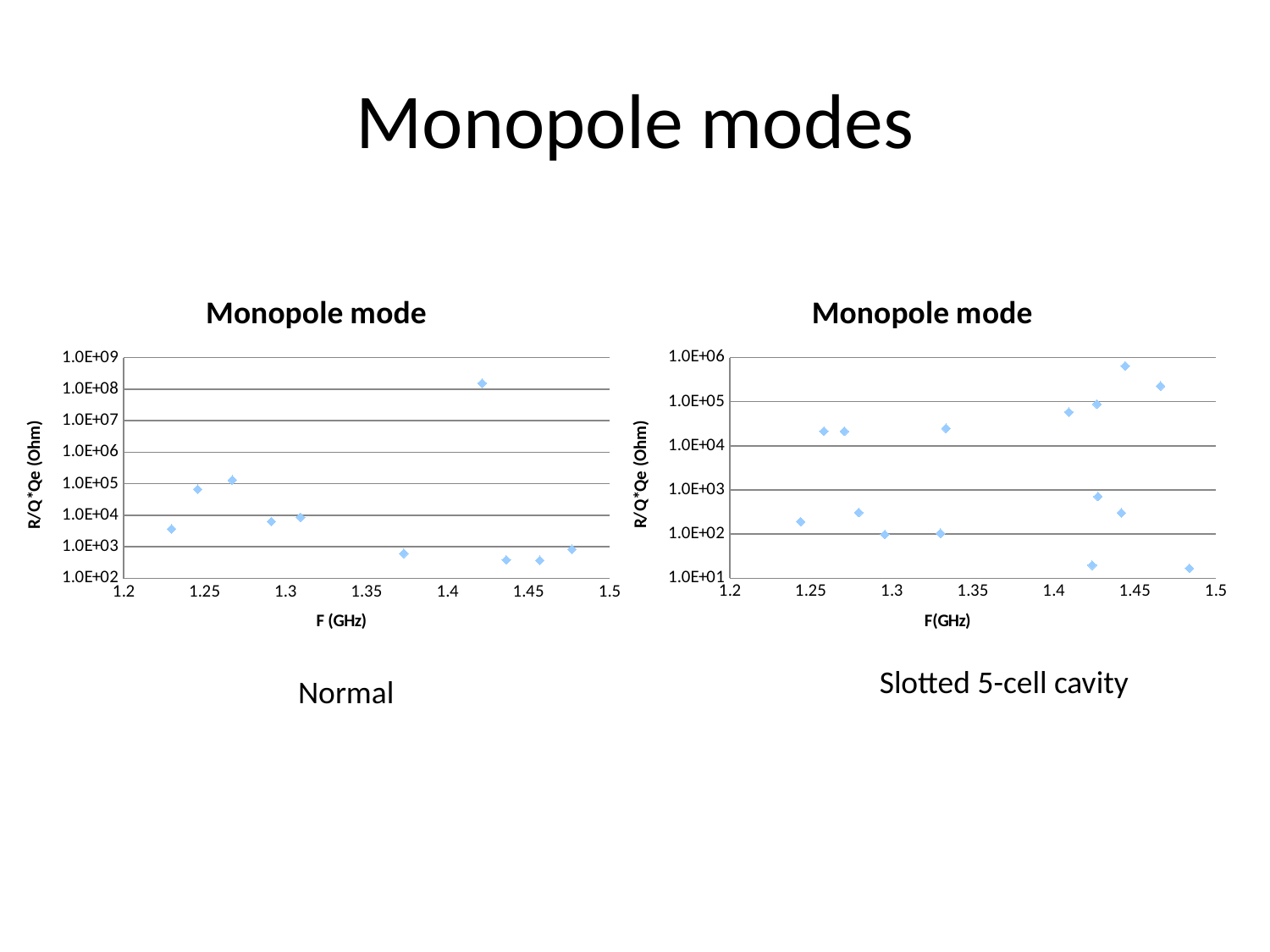
What is the maximum value shown on the y-axis of the left chart labelled "Normal"? 1.0E+09 On the right chart labelled "Slotted 5-cell cavity", is the lowest point greater or less than 1.0E+02? less What is the y-axis label on the left chart labelled "Normal"? R/Q*Qe (Ohm) What is the title of the right chart labelled "Slotted 5-cell cavity"? Monopole mode What is the minimum value shown on the x-axis of the right chart labelled "Slotted 5-cell cavity"? 1.2 On the right chart labelled "Slotted 5-cell cavity", is the highest point greater or less than 1.0E+05? greater On the left chart labelled "Normal", how many data points are plotted? 10 On the left chart labelled "Normal", is the highest point greater or less than 1.0E+07? greater What kind of chart is the left chart labelled "Normal"? scatter chart What is the maximum value shown on the y-axis of the right chart labelled "Slotted 5-cell cavity"? 1.0E+06 Which chart has the higher maximum plotted value, the left chart labelled "Normal" or the right chart labelled "Slotted 5-cell cavity"? Normal